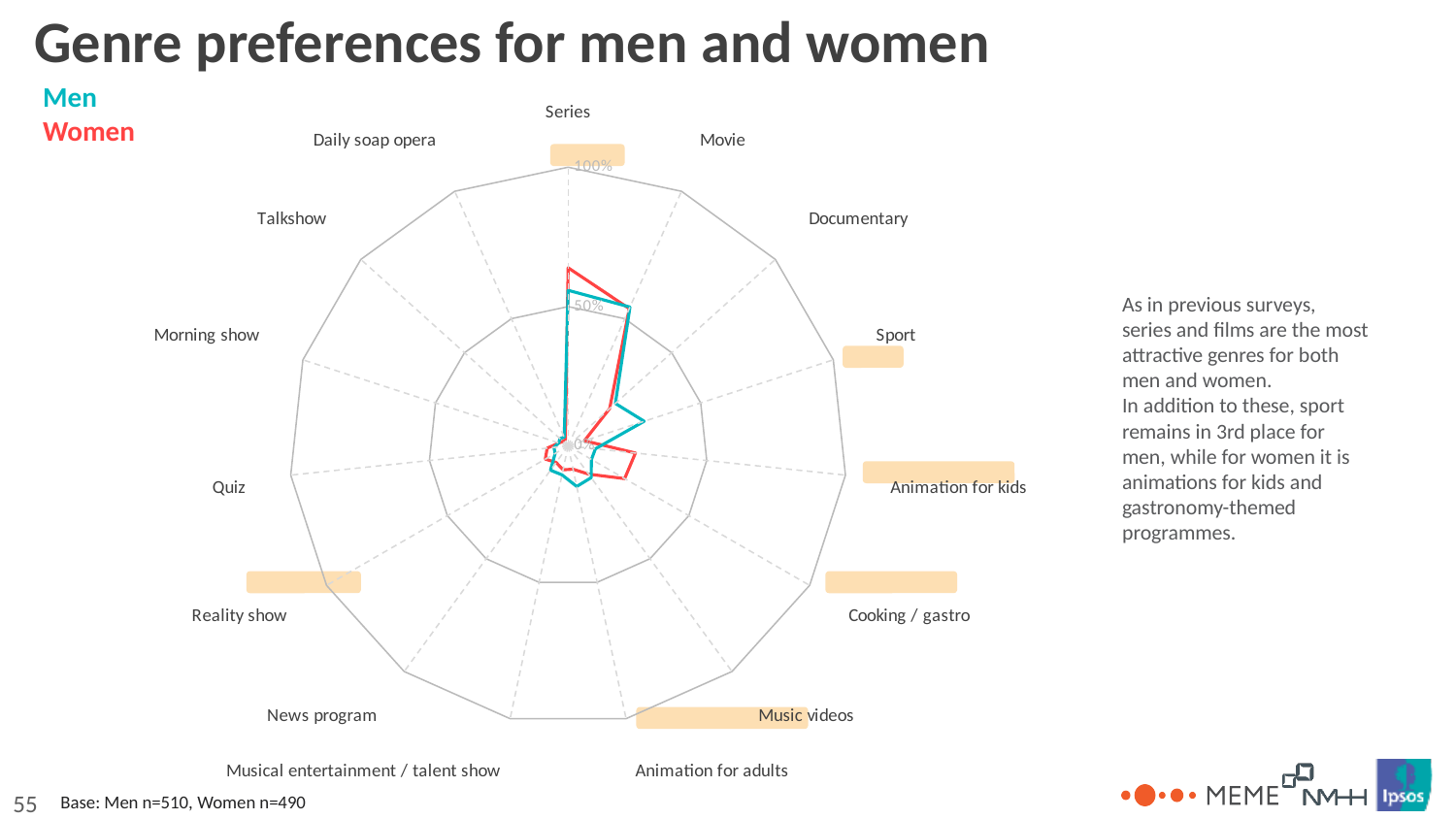
Which colour represents Men in the chart? Cyan Which colour represents Women in the chart? Red Is the value for Reality show among Women greater or less than 50%? less Which genre has the highest value for Women? Series For Sport, which group has the higher value, Men or Women? Men What kind of chart is shown on the slide? Radar chart Is the value for Sport among Men greater or less than 50%? less For Animation for kids, which group has the higher value, Men or Women? Women For Series, which group has the higher value, Men or Women? Women How many series does the chart plot? 2 How many genre categories are shown around the radar chart? 15 Is the value for Series among Women greater or less than 50%? greater